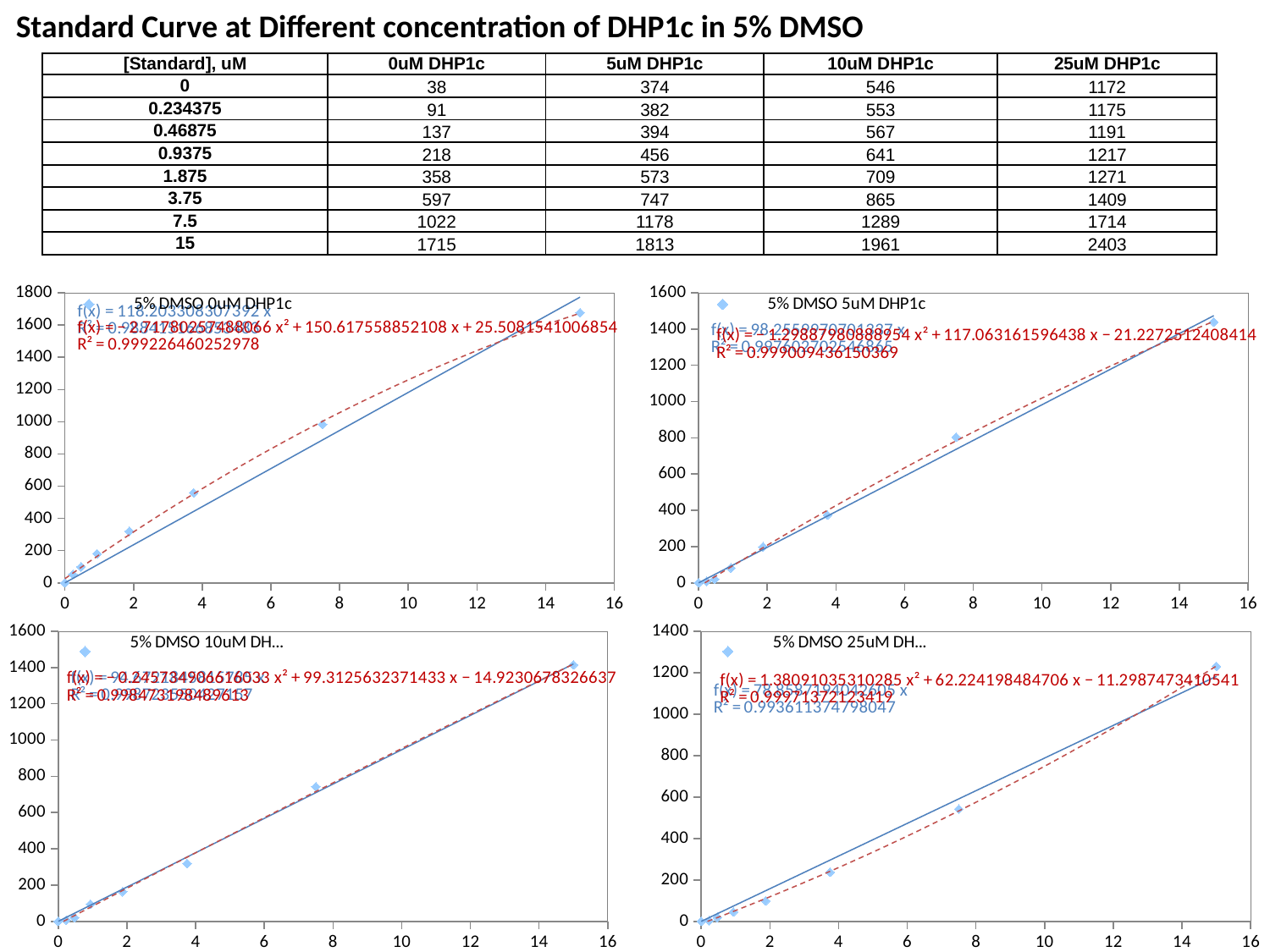
What kind of chart is the top-left chart titled '5% DMSO 0uM DHP1c'? scatter chart with trendlines In the bottom-left chart '5% DMSO 10uM DH...', do the plotted values rise or fall as x increases? rise In the top-left chart '5% DMSO 0uM DHP1c', is the value at x = 15 greater or less than 1600? greater In the bottom-right chart '5% DMSO 25uM DH...', is the value at x = 15 greater or less than 1000? greater In the top-right chart '5% DMSO 5uM DHP1c', is the value at x = 7.5 greater or less than 600? greater How many data points are plotted in the bottom-right chart '5% DMSO 25uM DH...'? 8 What is the title of the top-left chart? 5% DMSO 0uM DHP1c In the top-right chart '5% DMSO 5uM DHP1c', at which x value is the highest plotted point? 15